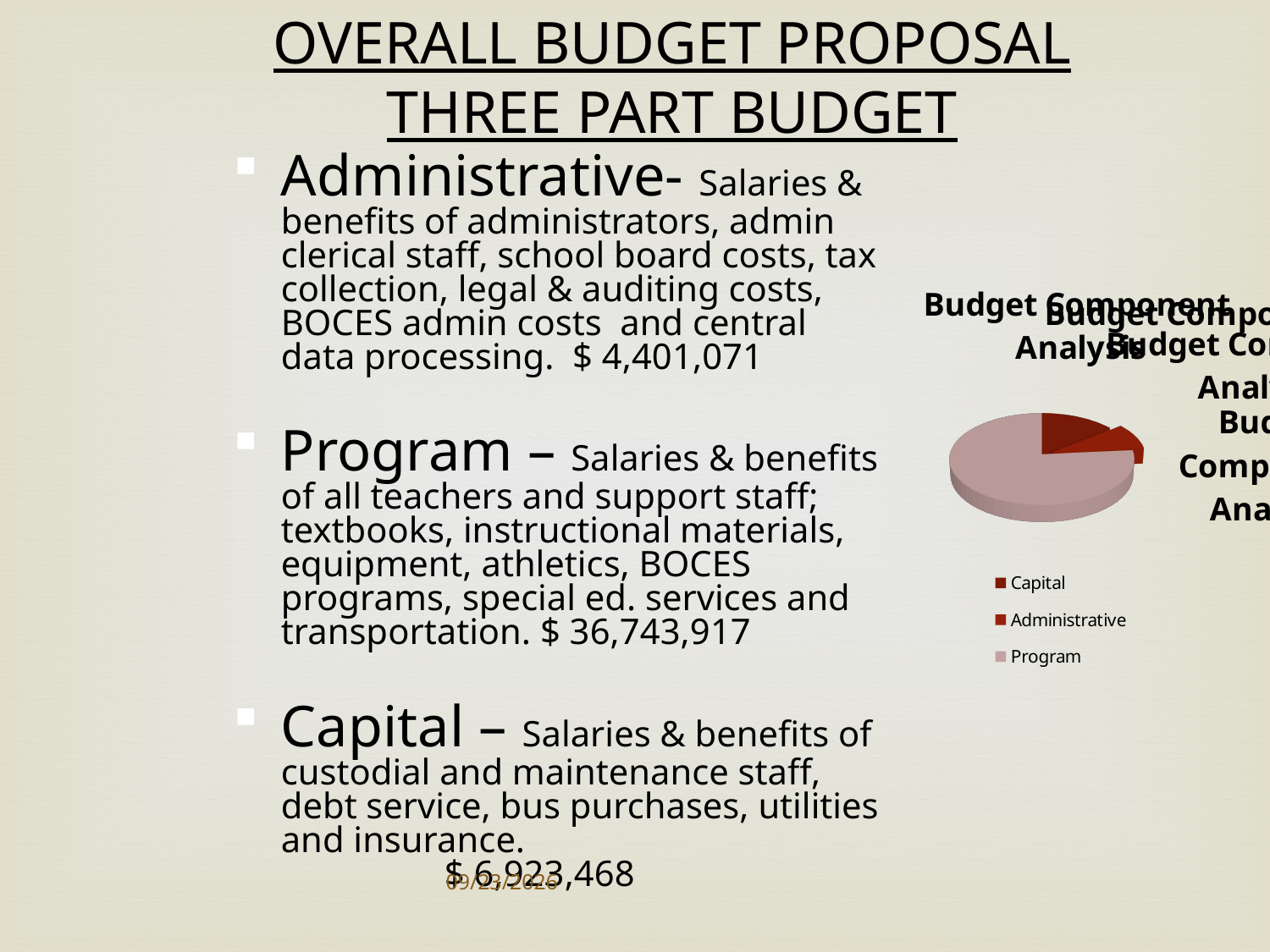
What is the title of the pie chart? Budget Component Analysis Which category has the largest slice of the pie chart? Program How many categories does the pie chart's legend list? 3 Which slice is larger in the pie chart, Program or Capital? Program Does the Program slice take up more or less than half of the pie chart? more What kind of chart is shown on the slide? pie chart Which legend entry is shown in the lightest pink colour in the pie chart? Program Which slice is larger in the pie chart, Program or Administrative? Program